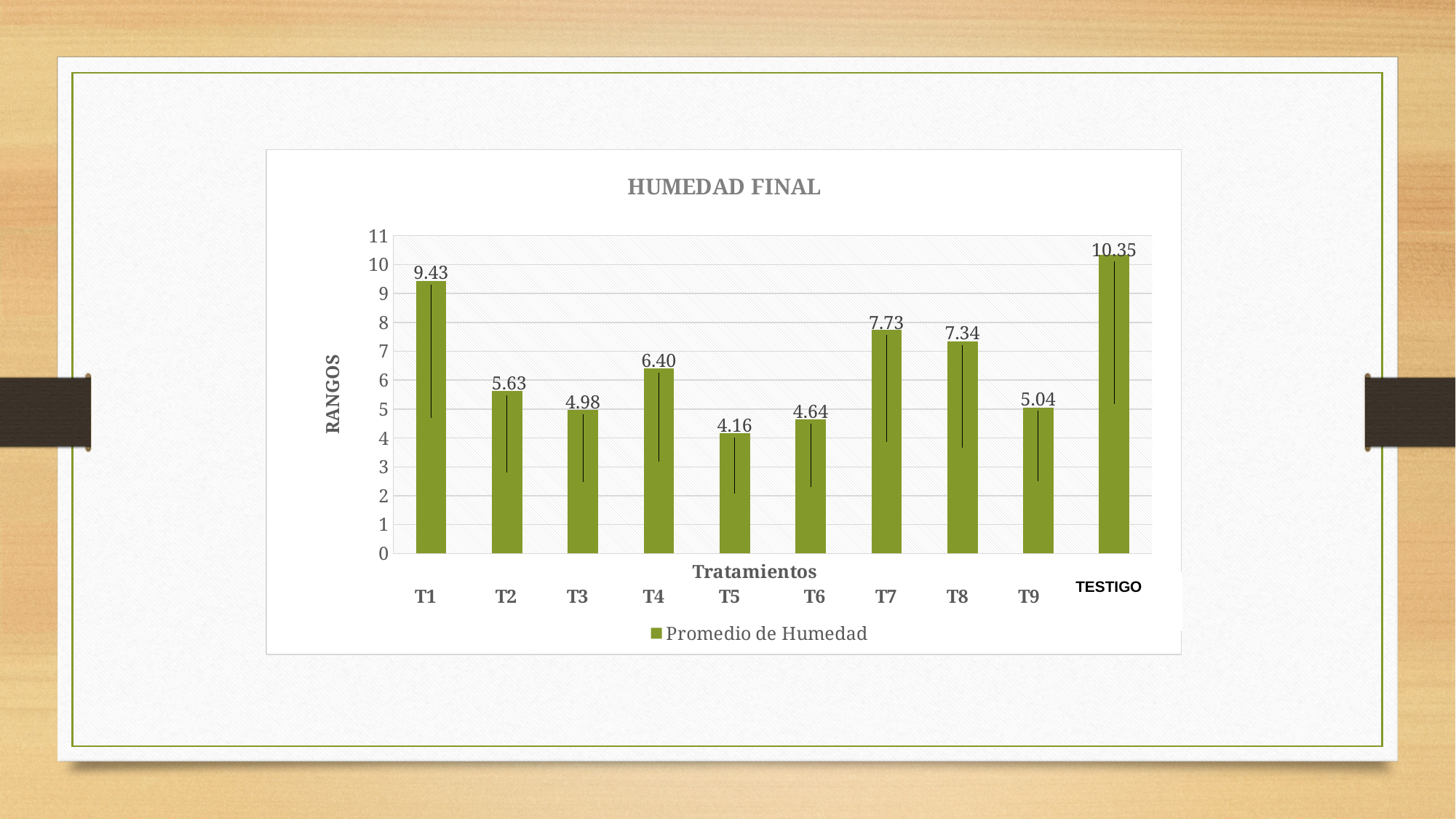
How many categories are shown on the x axis? 10 What is the difference between the values for T7 and T8? 0.39 Which category has the lowest value? T5 How many series does the legend list? 1 What is the title of the chart? HUMEDAD FINAL Which category has the highest value? TESTIGO What is the value for TESTIGO? 10.35 What kind of chart is this? bar chart What is the value for T5? 4.16 Which is larger, the value for T2 or the value for T4? T4 What is the label of the y axis? RANGOS What is the value for T1? 9.43